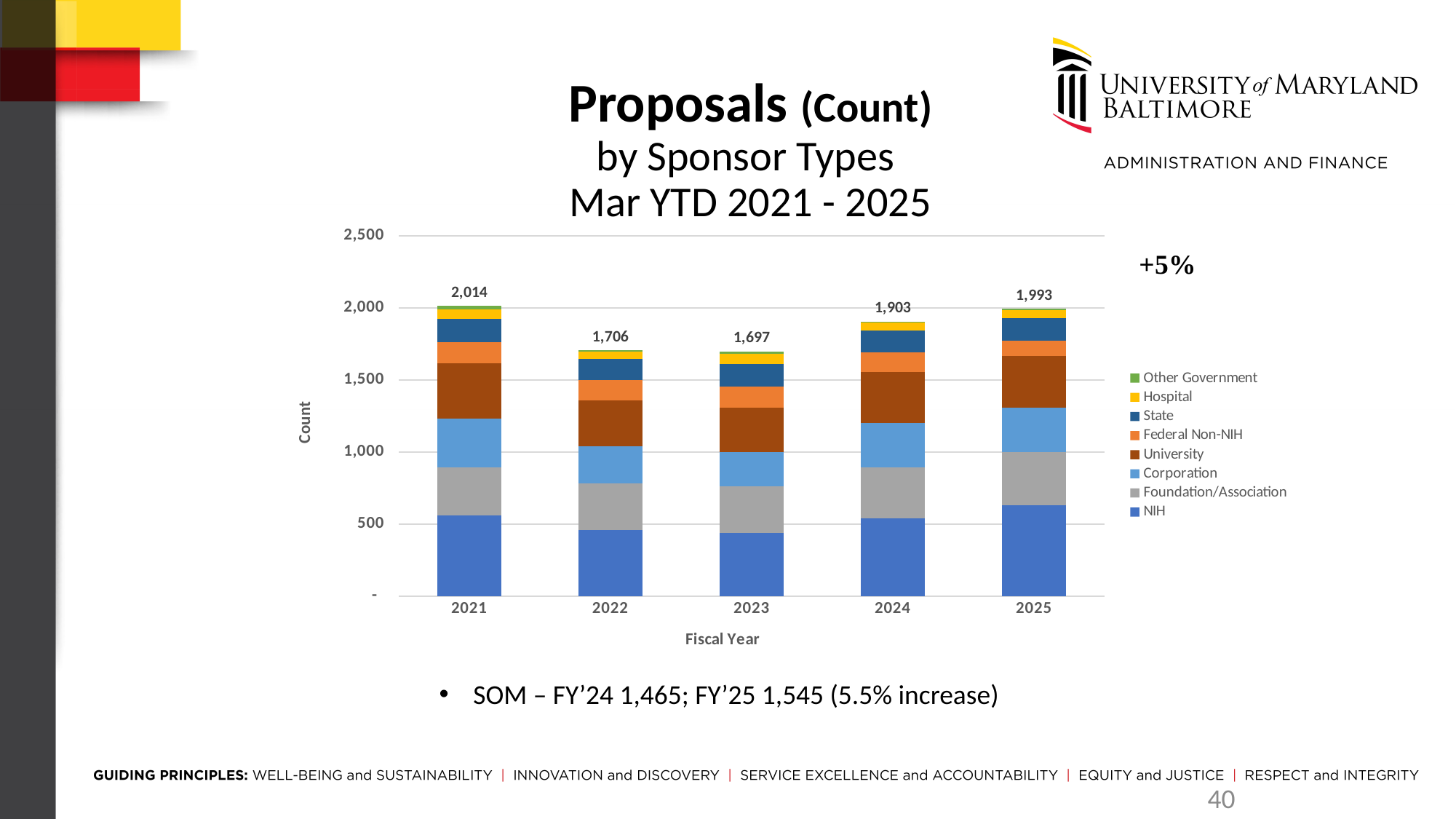
What is the total proposal count for fiscal year 2021? 2,014 Which fiscal year has the lowest total proposal count? 2023 What is the total proposal count for fiscal year 2025? 1,993 What is the difference between the total proposal counts for 2025 and 2024? 90 What is the difference between the total proposal counts for 2021 and 2022? 308 What kind of chart is shown on the slide? Stacked bar chart Which fiscal year has the highest total proposal count? 2021 How many sponsor types does the legend list? 8 Is the NIH value for 2025 greater or less than 500? greater What is the total proposal count for fiscal year 2023? 1,697 How many fiscal years are shown on the x axis? 5 Which fiscal year has a larger total proposal count, 2022 or 2024? 2024